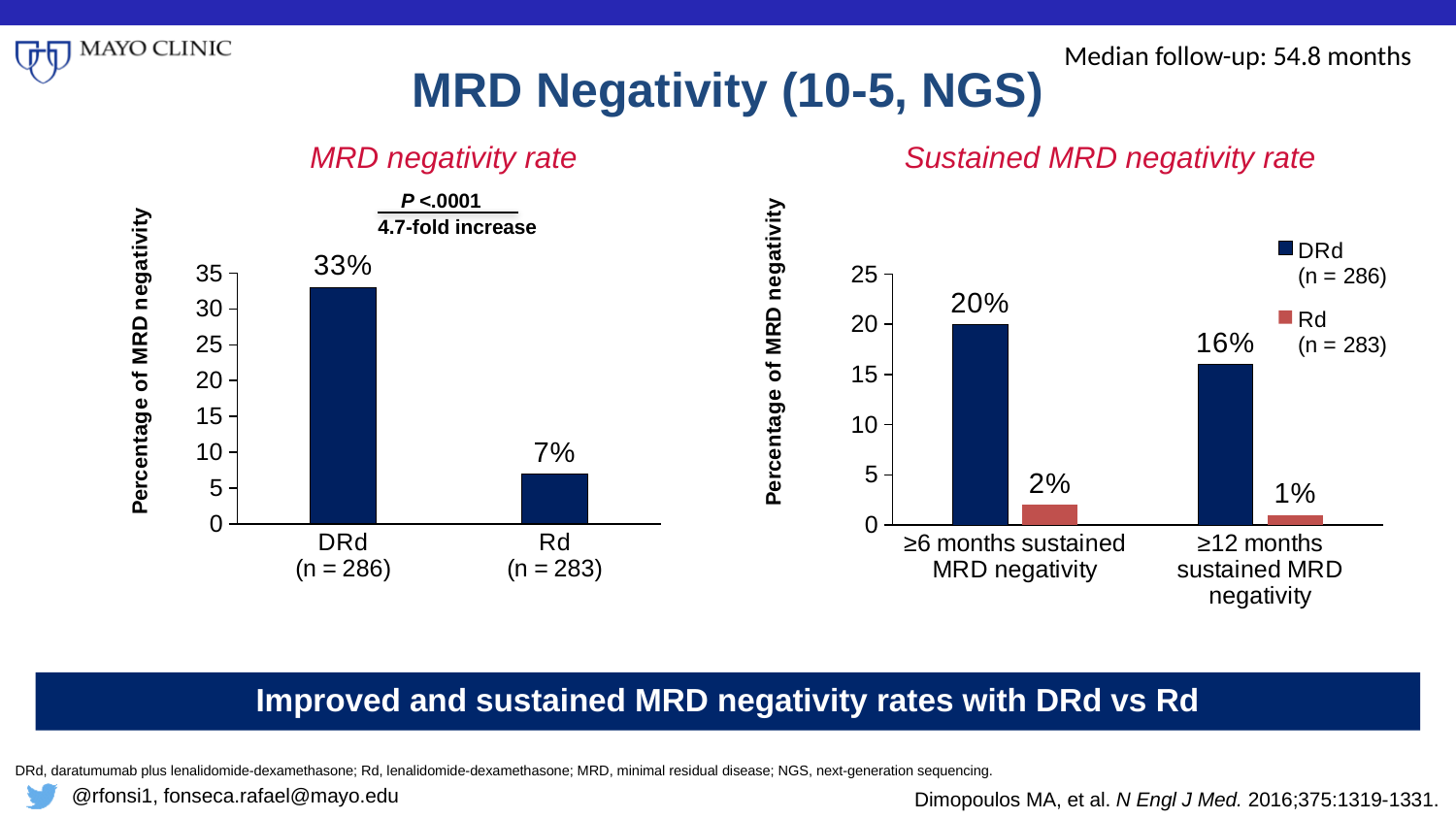
In the 'Sustained MRD negativity rate' chart, what is the DRd value for ≥6 months sustained MRD negativity? 20% In the 'Sustained MRD negativity rate' chart, how many series does the legend list? 2 In the 'MRD negativity rate' chart, which group has the higher value, DRd or Rd? DRd In the 'MRD negativity rate' chart, what is the value for Rd? 7% In the 'Sustained MRD negativity rate' chart, what is the Rd value for ≥12 months sustained MRD negativity? 1% In the 'Sustained MRD negativity rate' chart, which series has the lowest value overall? Rd In the 'Sustained MRD negativity rate' chart, what colour represents the Rd series? Red In the 'Sustained MRD negativity rate' chart, what is the difference between the DRd and Rd values for ≥6 months sustained MRD negativity? 18% In the 'MRD negativity rate' chart, how many bars are plotted? 2 What kind of chart is the 'Sustained MRD negativity rate' chart? Bar chart In the 'MRD negativity rate' chart, what is the difference between the DRd and Rd values? 26% In the 'MRD negativity rate' chart, what is the value for DRd? 33%